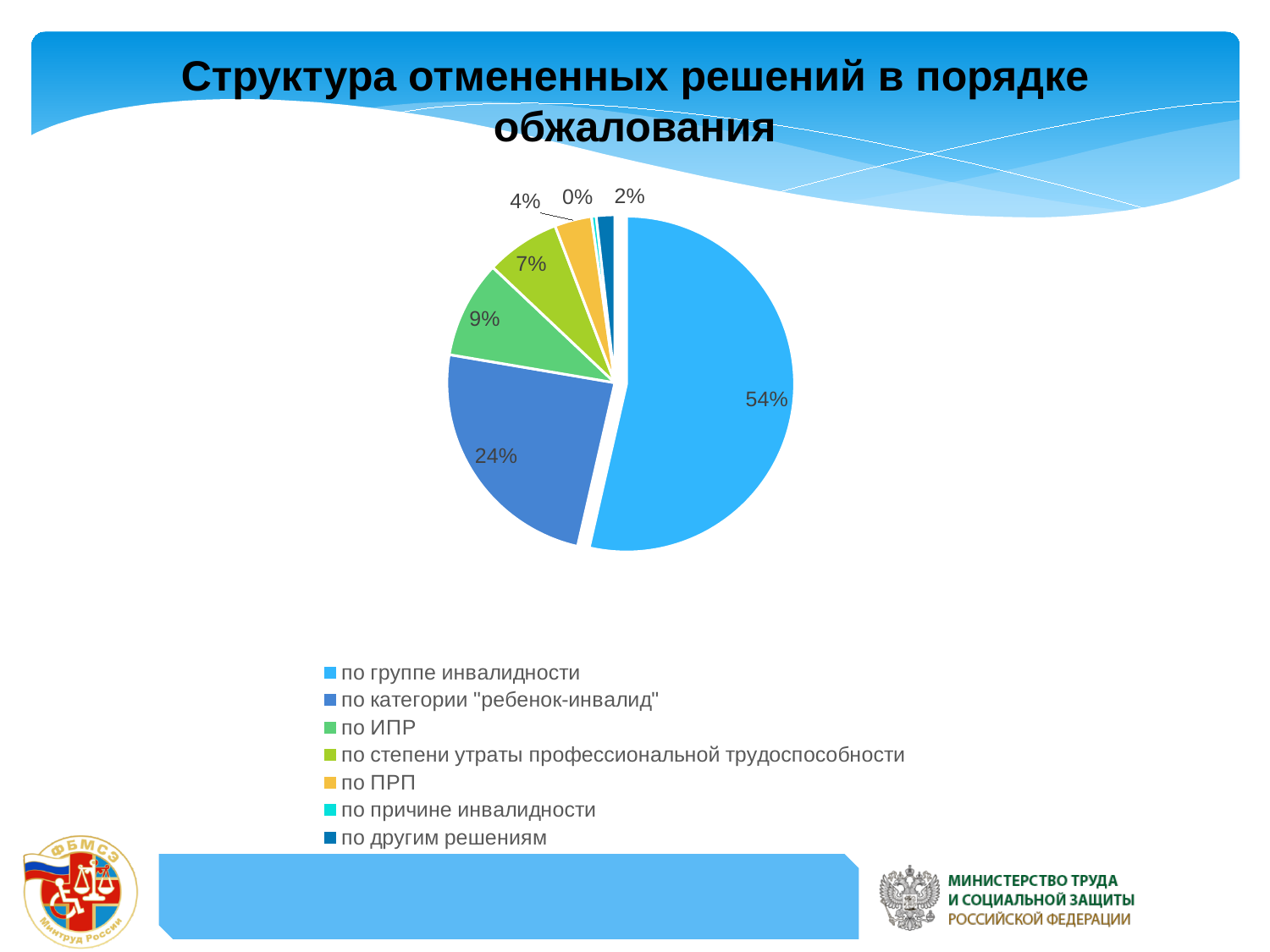
What share of the pie does "по группе инвалидности" account for? 54% What is the difference in percentage points between "по группе инвалидности" and "по категории "ребенок-инвалид""? 30 What share of the pie does "по ПРП" account for? 4% How many categories does the legend list? 7 What share of the pie does "по категории "ребенок-инвалид"" account for? 24% Which is larger: the slice for "по ИПР" or the slice for "по степени утраты профессиональной трудоспособности"? по ИПР What is the title of the slide? Структура отмененных решений в порядке обжалования What share of the pie does "по другим решениям" account for? 2% Which category has the smallest slice of the pie? по причине инвалидности Which category has the largest slice of the pie? по группе инвалидности What kind of chart is shown on the slide? pie chart What share of the pie does "по ИПР" account for? 9%